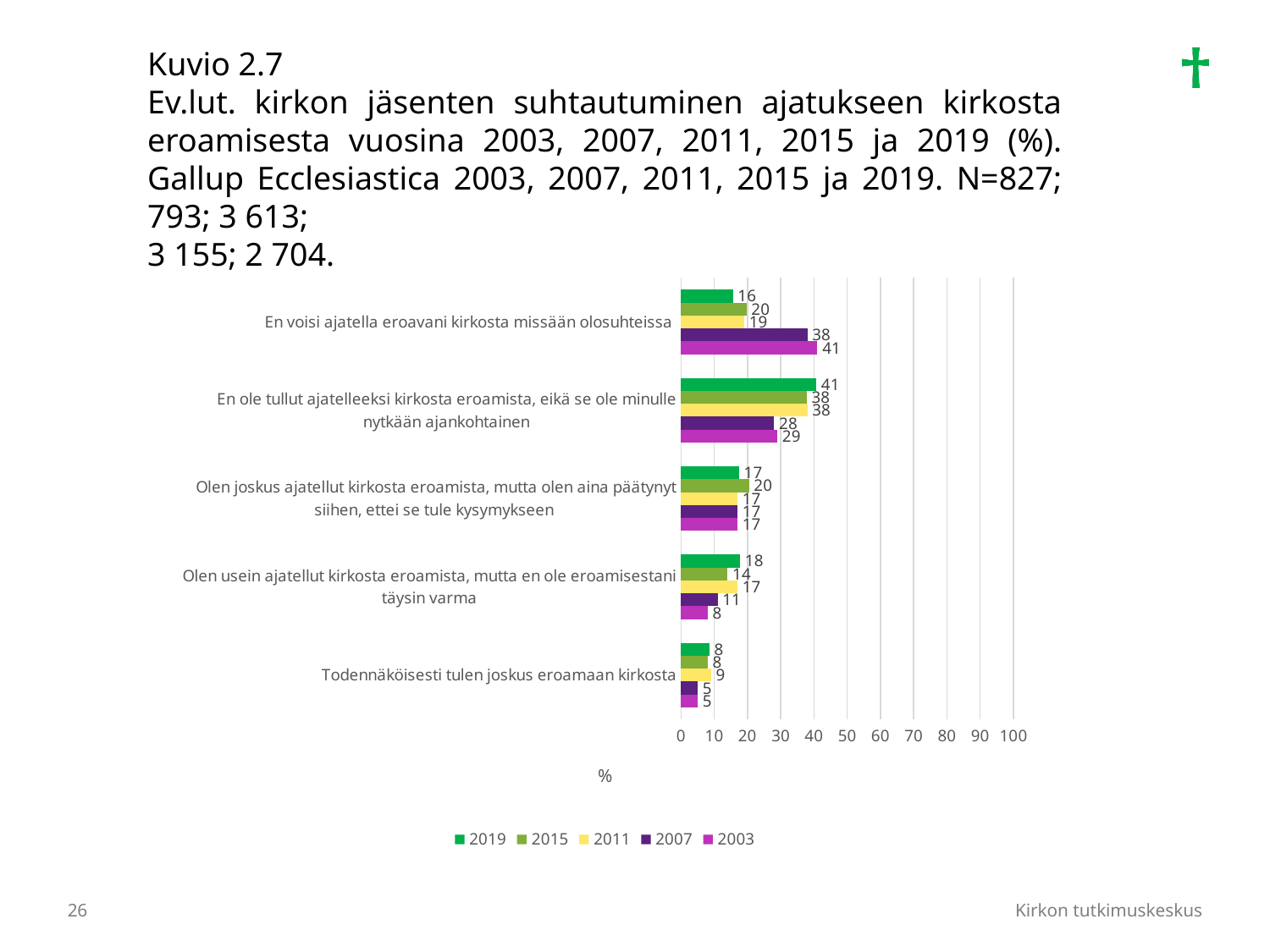
How many series does the legend list? 5 What is the 2003 value for "En voisi ajatella eroavani kirkosta missään olosuhteissa"? 41 Which year has the highest value for "En ole tullut ajatelleeksi kirkosta eroamista, eikä se ole minulle nytkään ajankohtainen"? 2019 What is the 2011 value for "Olen usein ajatellut kirkosta eroamista, mutta en ole eroamisestani täysin varma"? 17 What is the 2007 value for "En ole tullut ajatelleeksi kirkosta eroamista, eikä se ole minulle nytkään ajankohtainen"? 28 What label is shown on the horizontal axis of the chart? % What type of chart is shown on the slide? bar chart Which year has the lowest value for "Olen usein ajatellut kirkosta eroamista, mutta en ole eroamisestani täysin varma"? 2003 What is the 2019 value for "En voisi ajatella eroavani kirkosta missään olosuhteissa"? 16 How many categories (statements) are shown on the chart? 5 What is the difference between the 2003 and 2019 values for "En voisi ajatella eroavani kirkosta missään olosuhteissa"? 25 For "Todennäköisesti tulen joskus eroamaan kirkosta", which is larger: the 2011 value or the 2007 value? 2011